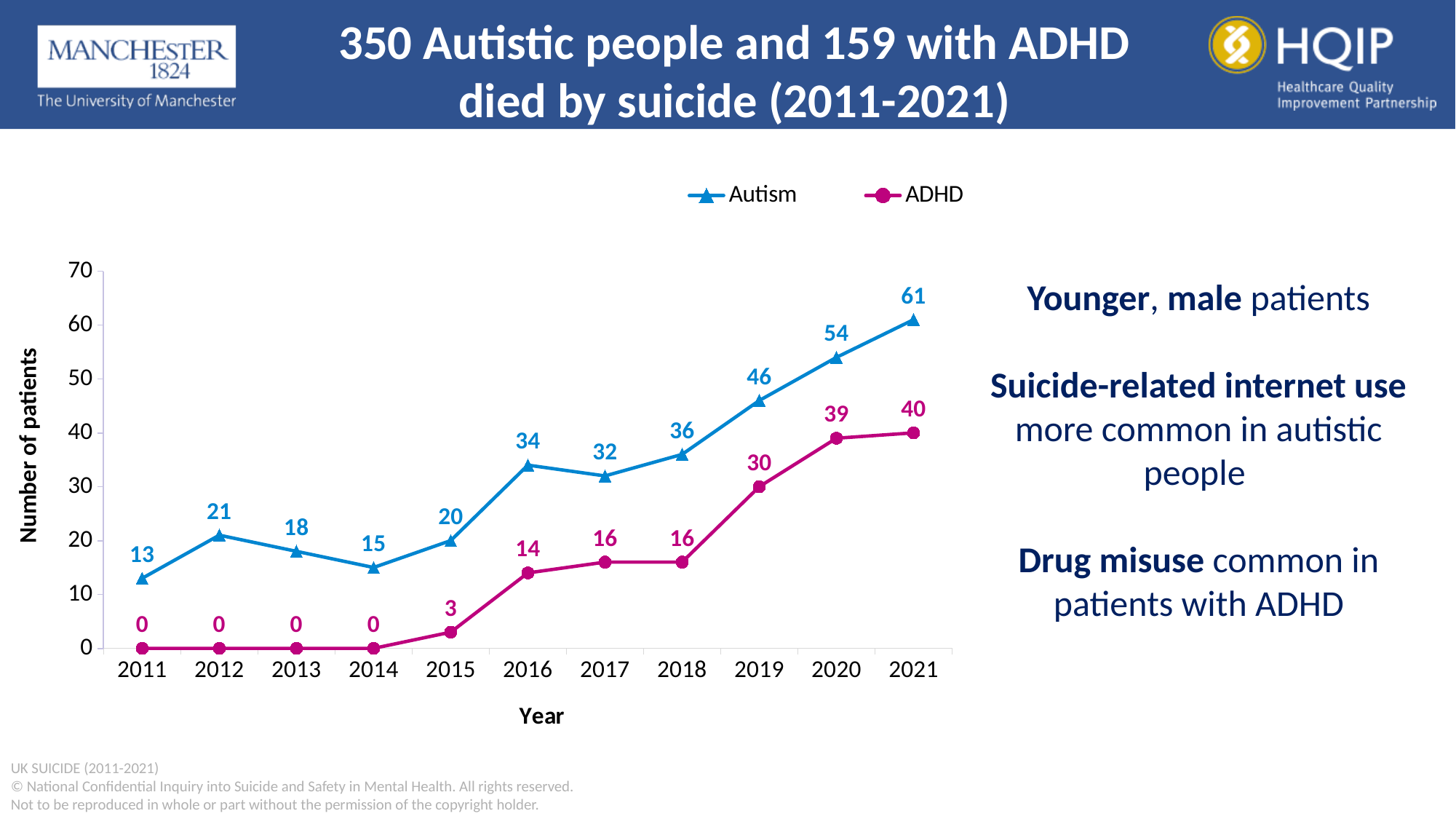
How many years are shown on the x axis? 11 In which year is the Autism series highest? 2021 In which year is the Autism series lowest? 2011 Which series has the larger value in 2018, Autism or ADHD? Autism What is the label of the y axis? Number of patients What is the value for ADHD in 2019? 30 How many series does the legend list? 2 What is the difference between the Autism values in 2020 and 2019? 8 Does the ADHD series generally rise or fall from 2014 to 2021? Rise What is the value for Autism in 2016? 34 What kind of chart is shown on the slide? Line chart What is the difference between the Autism and ADHD values in 2021? 21